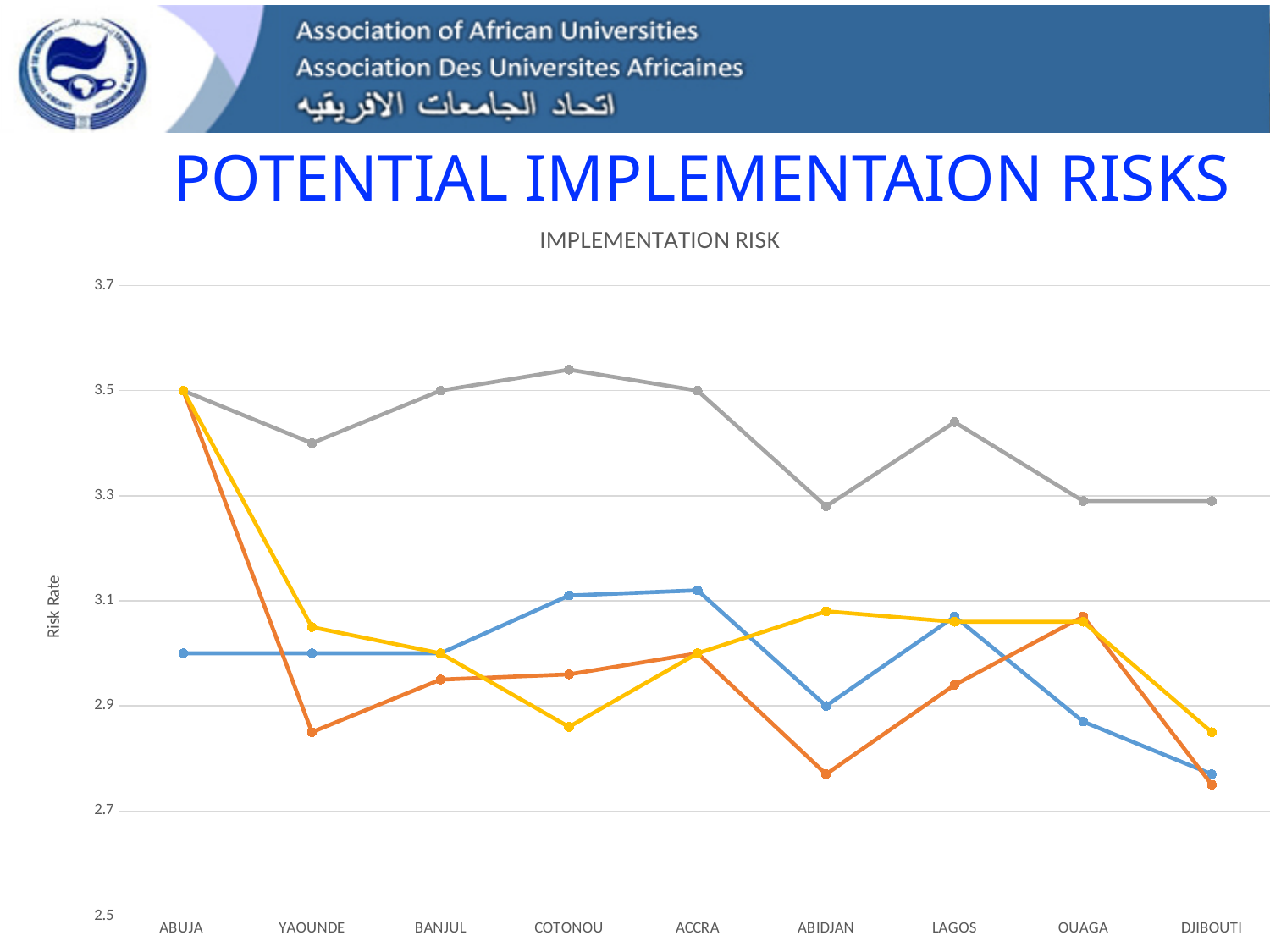
At which city does the gray line reach its highest value? COTONOU Does the gray line rise or fall overall from ABUJA to DJIBOUTI? fall How many cities are shown along the x axis of the chart? 9 At ABIDJAN, which line has the larger value, the gray line or the orange line? gray line What kind of chart is shown on the slide? line chart What is the value of the blue line at ABIDJAN? 2.9 What is the value of the gray line at ACCRA? 3.5 What is the label on the vertical axis of the chart? Risk Rate What is the title of the chart? IMPLEMENTATION RISK Is the value of the orange line at YAOUNDE greater or less than 2.9? less What is the value of the gray line at ABUJA? 3.5